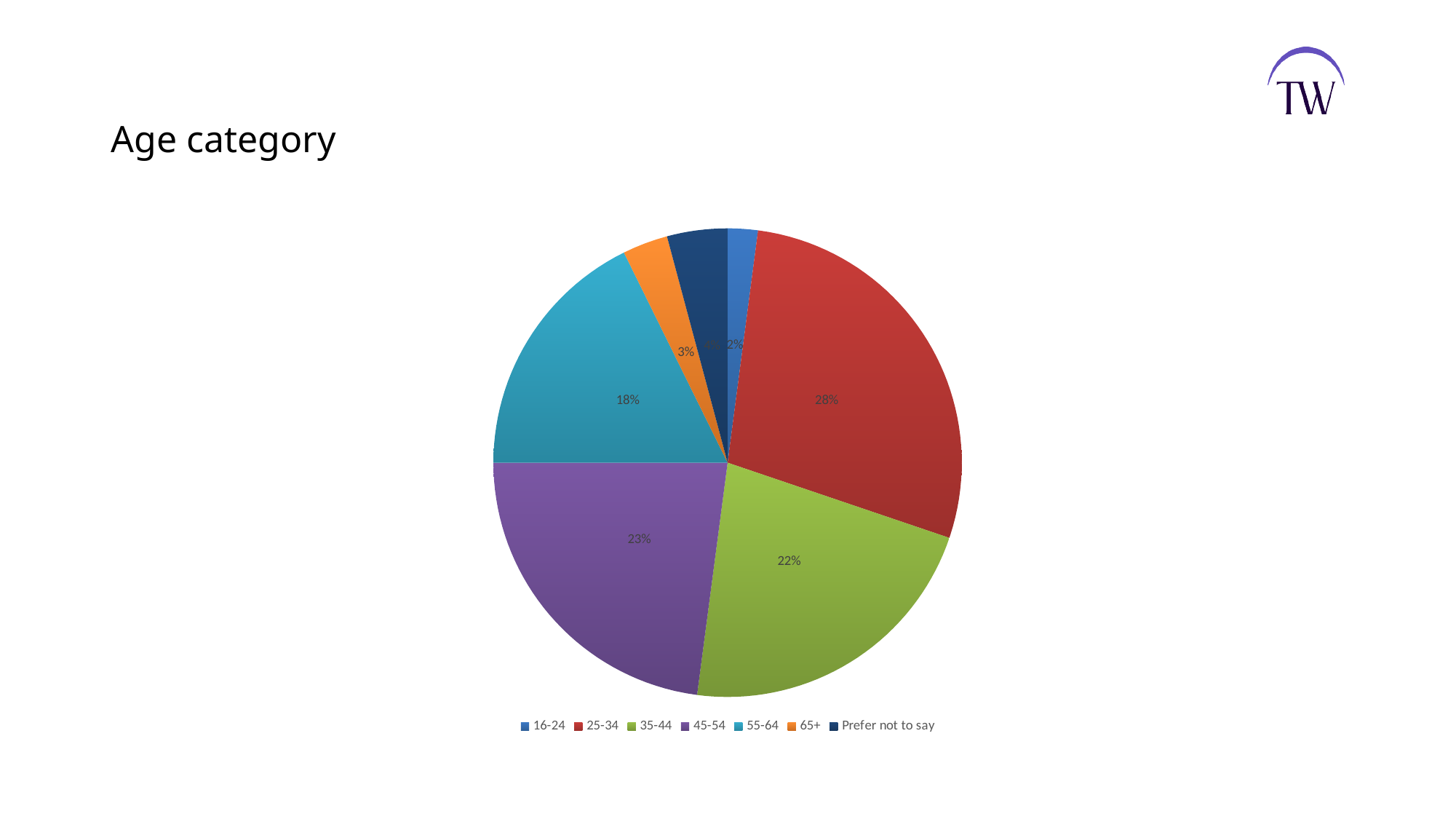
What share of the pie does the 55-64 age category have? 18% Which category has the smallest share of the pie? 16-24 What share of the pie does the 'Prefer not to say' category have? 4% What is the title of the chart? Age category What is the difference in percentage points between the 25-34 and 55-64 categories? 10 What share of the pie does the 65+ age category have? 3% Which age category has the largest share of the pie? 25-34 What type of chart is shown on the slide? pie chart Which has a larger share, 35-44 or 55-64? 35-44 How many categories does the legend list? 7